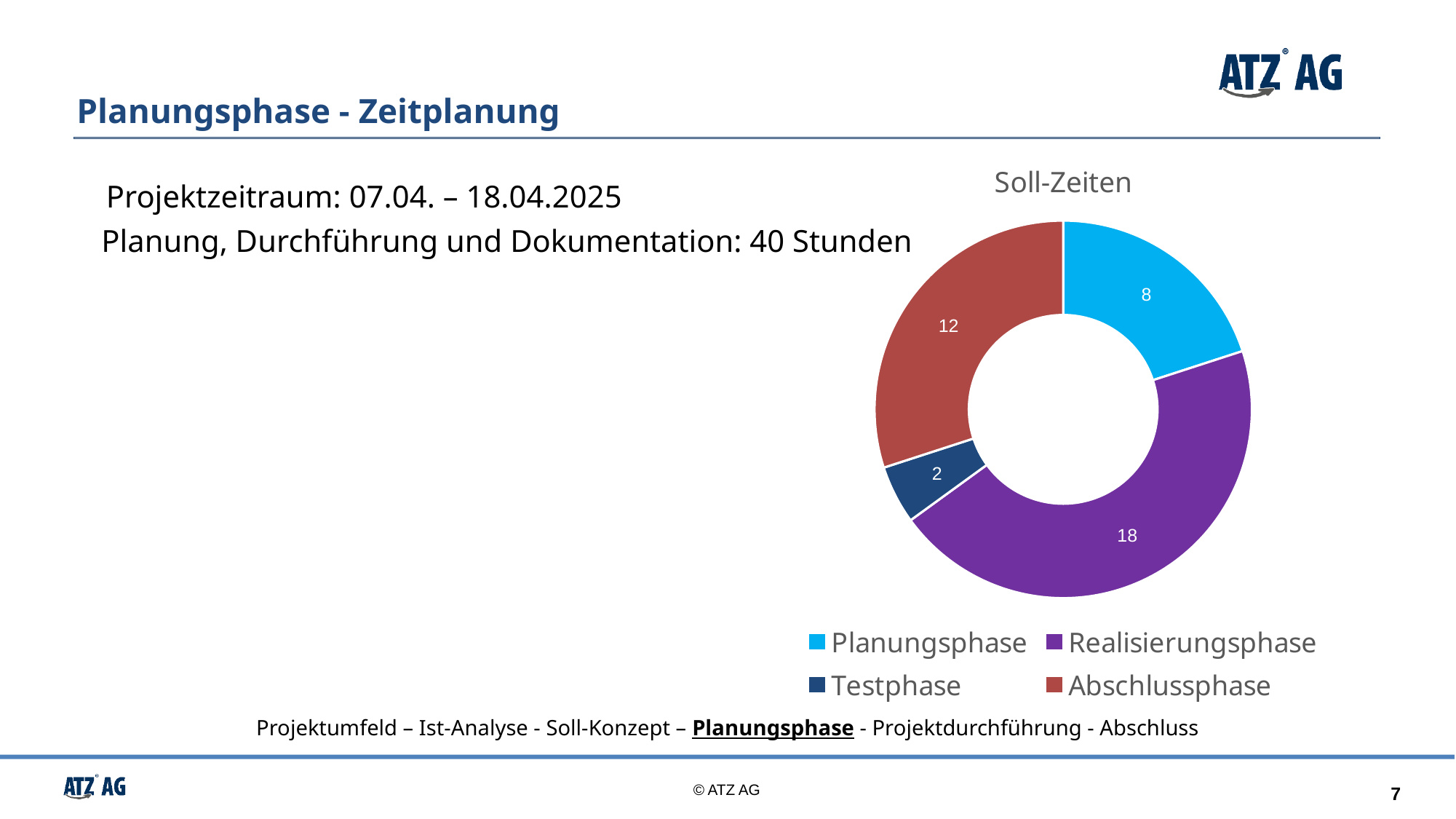
What kind of chart is the Soll-Zeiten chart? Doughnut chart What is the difference between the values for Realisierungsphase and Abschlussphase? 6 What is the value for Planungsphase in the Soll-Zeiten chart? 8 What is the value for Abschlussphase in the Soll-Zeiten chart? 12 Which is larger, the value for Planungsphase or the value for Abschlussphase? Abschlussphase What is the value for Testphase in the Soll-Zeiten chart? 2 What is the total of all values in the Soll-Zeiten chart? 40 What is the value for Realisierungsphase in the Soll-Zeiten chart? 18 What is the title of the chart on the slide? Soll-Zeiten Which phase has the smallest value in the Soll-Zeiten chart? Testphase Which phase has the largest value in the Soll-Zeiten chart? Realisierungsphase How many phases are shown in the Soll-Zeiten chart? 4